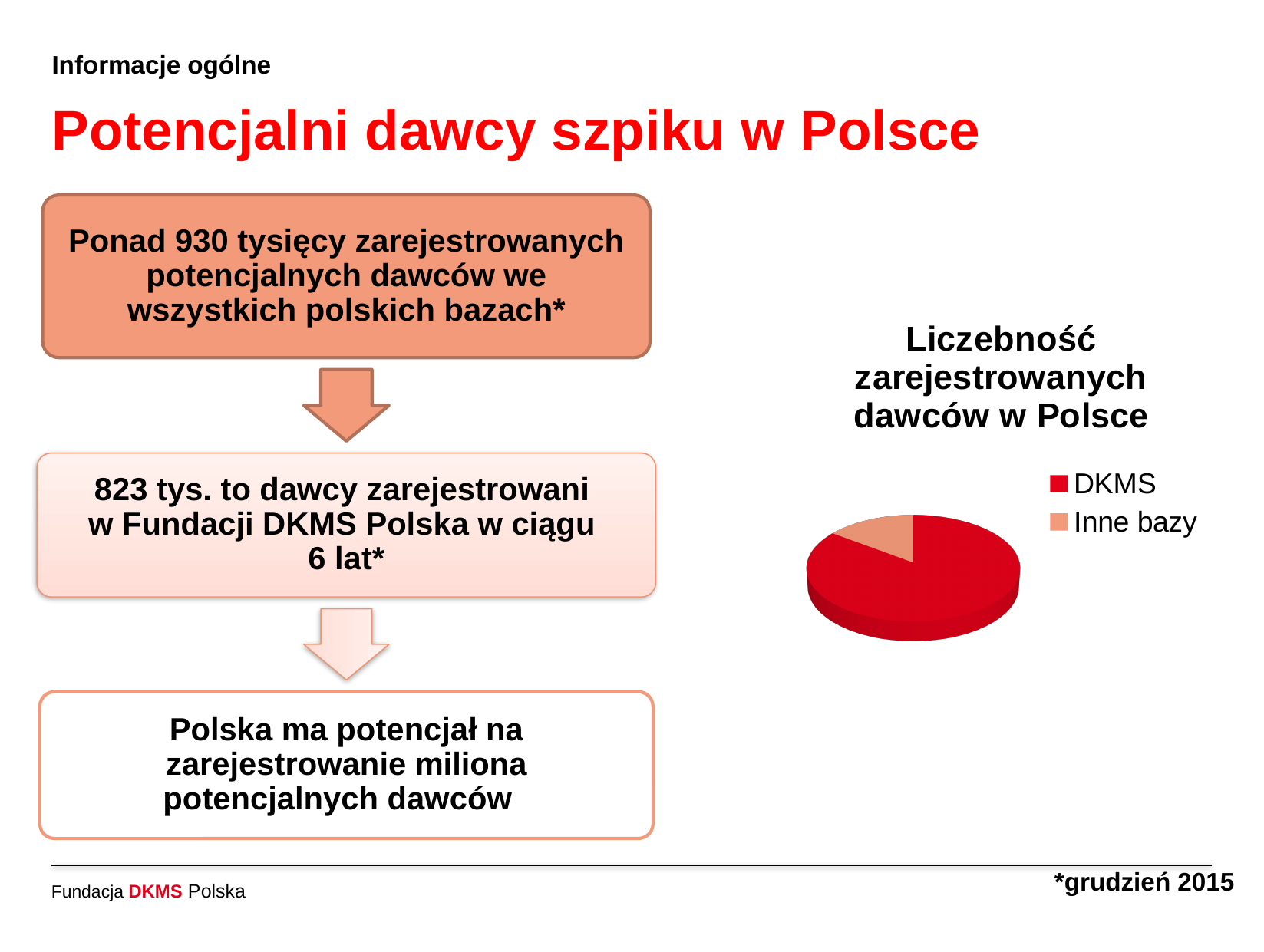
How many entries does the legend of the pie chart list? 2 Which slice of the pie chart is the largest? DKMS In the pie chart, which is larger: DKMS or Inne bazy? DKMS What kind of chart is shown on the slide? pie chart Which slice of the pie chart is the smallest? Inne bazy How many slices does the pie chart have? 2 What is the title of the pie chart? Liczebność zarejestrowanych dawców w Polsce What colour represents DKMS in the pie chart? red